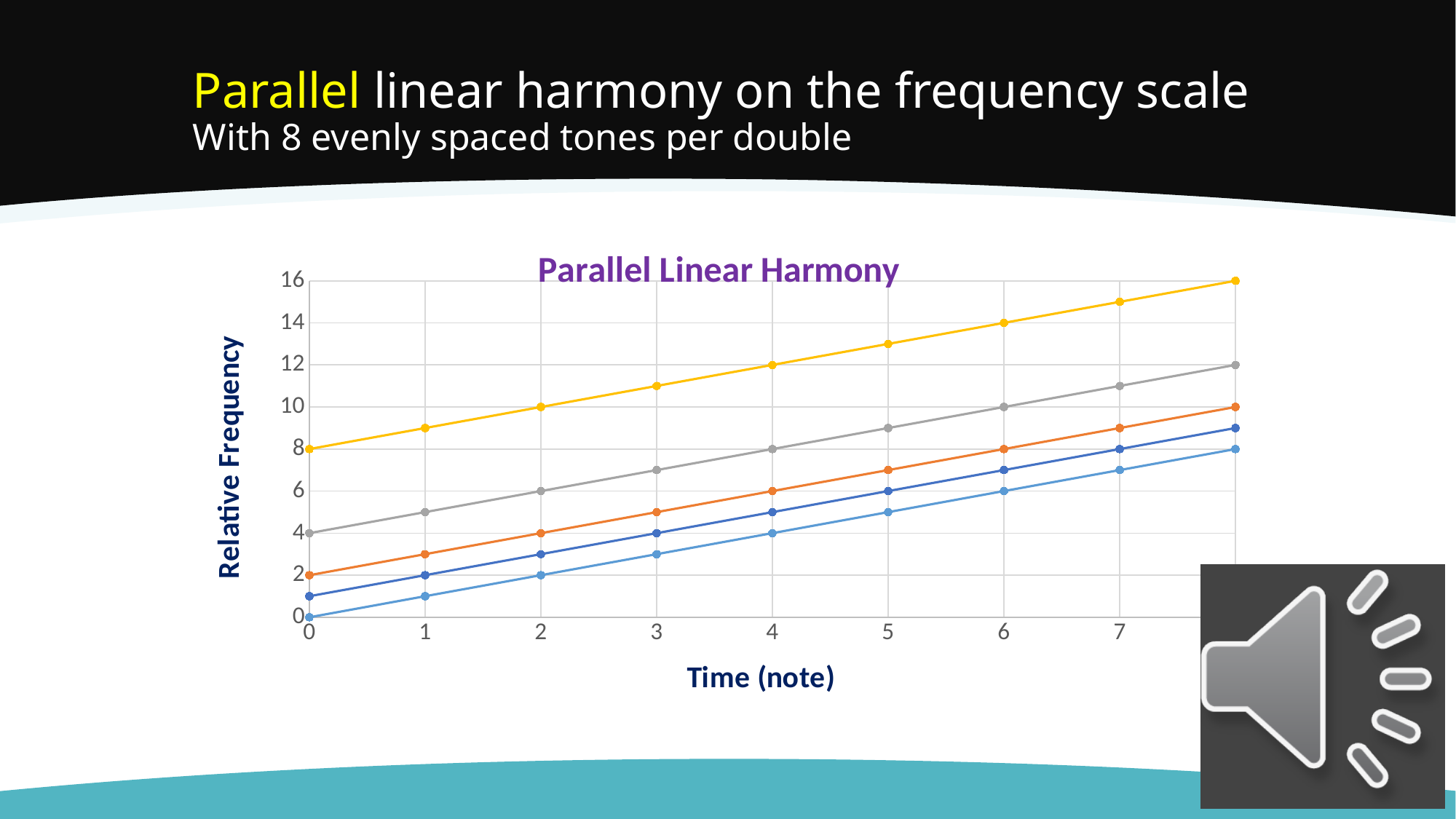
What kind of chart is shown on the slide? line chart Is the value of the yellow line at time 7 greater or less than 14? greater What is the relative frequency of the orange line at time 0? 2 Do the lines rise or fall as time increases along the x axis? rise How many lines are plotted on the chart? 5 What is the difference between the yellow line and the gray line at time 0? 4 What is the title of the chart? Parallel Linear Harmony What is the relative frequency of the yellow line at time 0? 8 Which line has the highest relative frequency at time 0? the yellow line What is the relative frequency of the gray line at time 4? 8 Which line has the lowest relative frequency at time 0? the light blue line What is the label on the vertical axis of the chart? Relative Frequency